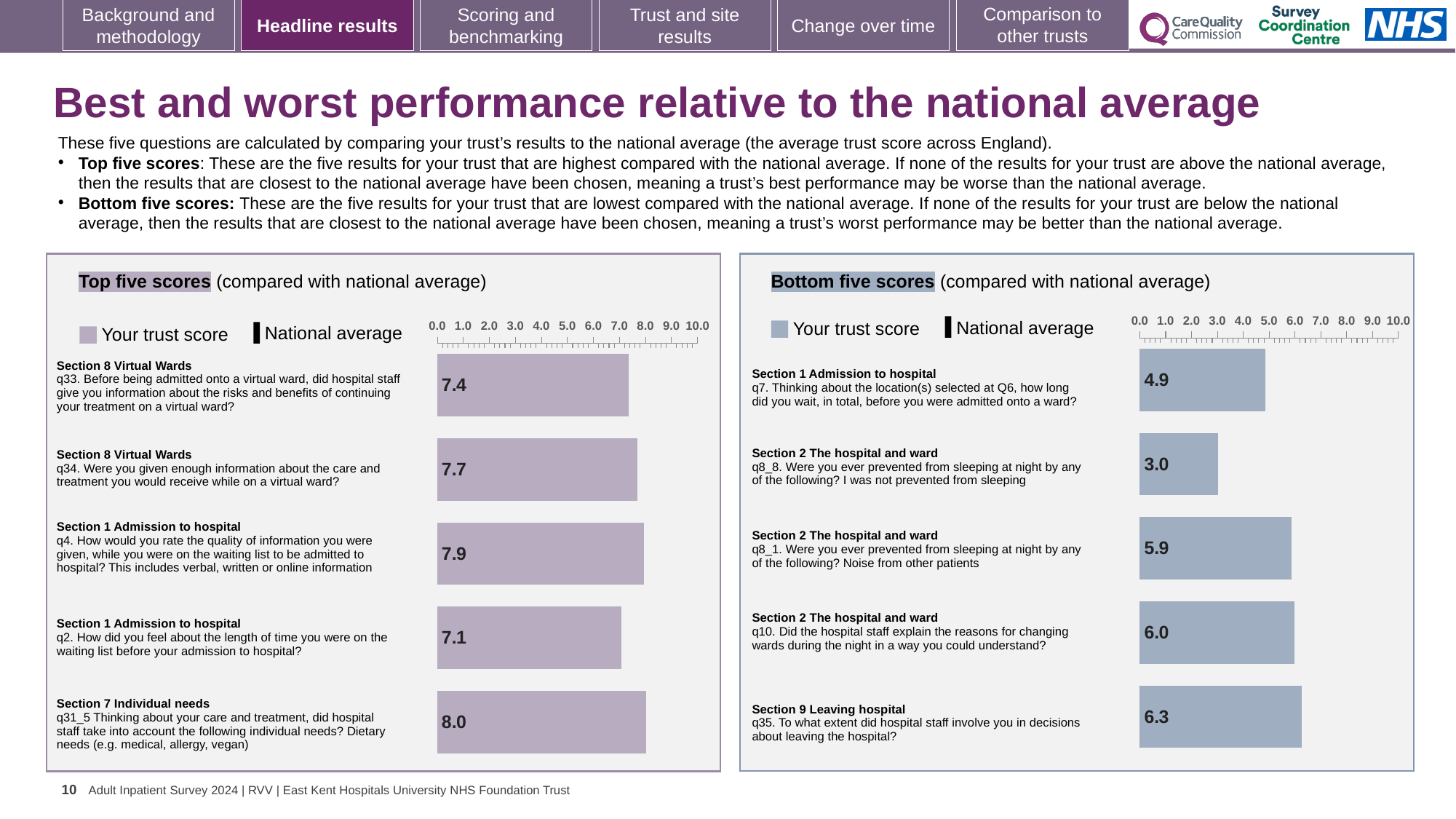
In the Top five scores chart, which question has the lowest trust score? q2 (Section 1 Admission to hospital), 7.1 In the Bottom five scores chart, what is the trust score for q7 (how long did you wait, in total, before you were admitted onto a ward?)? 4.9 In the Top five scores chart, what is the trust score for q34 (Were you given enough information about the care and treatment you would receive while on a virtual ward?)? 7.7 In the Top five scores chart, which question has the highest trust score? q31_5 (Section 7 Individual needs), 8.0 In the Bottom five scores chart, which question has the lowest trust score? q8_8 (Section 2 The hospital and ward), 3.0 In the Top five scores chart, what is the trust score for q2 (How did you feel about the length of time you were on the waiting list before your admission to hospital?)? 7.1 In the Top five scores chart, what is the difference between the trust scores for q31_5 and q2? 0.9 How many bars are shown in the Bottom five scores chart? 5 What kind of chart is the Top five scores chart? Bar chart In the Bottom five scores chart, which has the larger trust score: q35 or q7? q35 In the Top five scores chart, is the trust score for q33 greater or less than 5.0? greater In the Bottom five scores chart, what is the difference between the trust scores for q35 and q8_8? 3.3